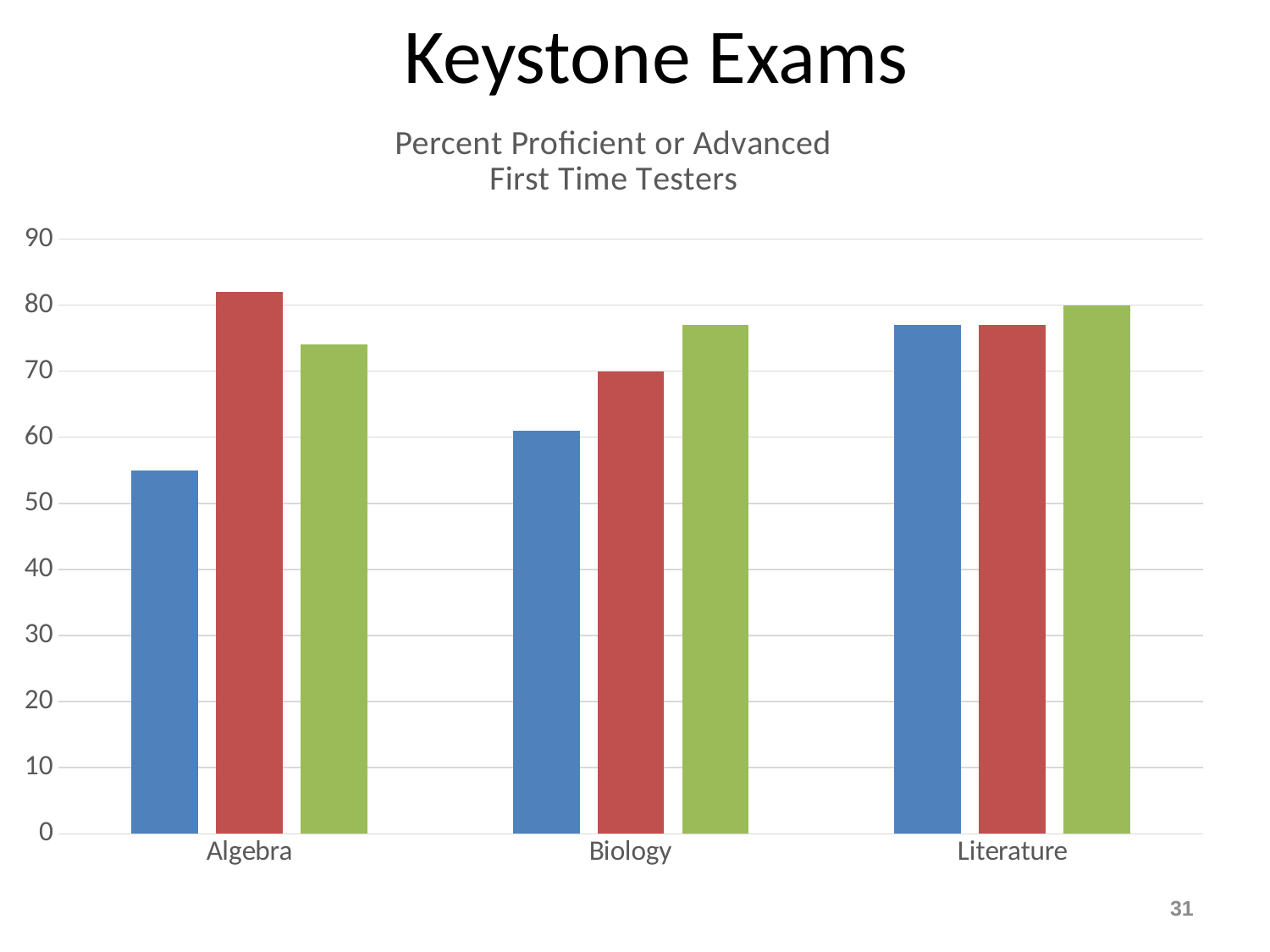
What is the title of the chart? Percent Proficient or Advanced First Time Testers For Algebra, which is larger, the blue bar or the red bar? the red bar What kind of chart is shown on the slide? bar chart Is the value of the blue bar for Algebra greater or less than 60? less How many bars are shown for each exam category? 3 Is the value of the blue bar for Literature greater or less than 80? less Do the blue bars rise or fall from Algebra to Literature along the x axis? rise Is the value of the red bar for Algebra greater or less than 70? greater How many exam categories are shown on the x axis? 3 Among the blue bars, which exam category has the highest value? Literature